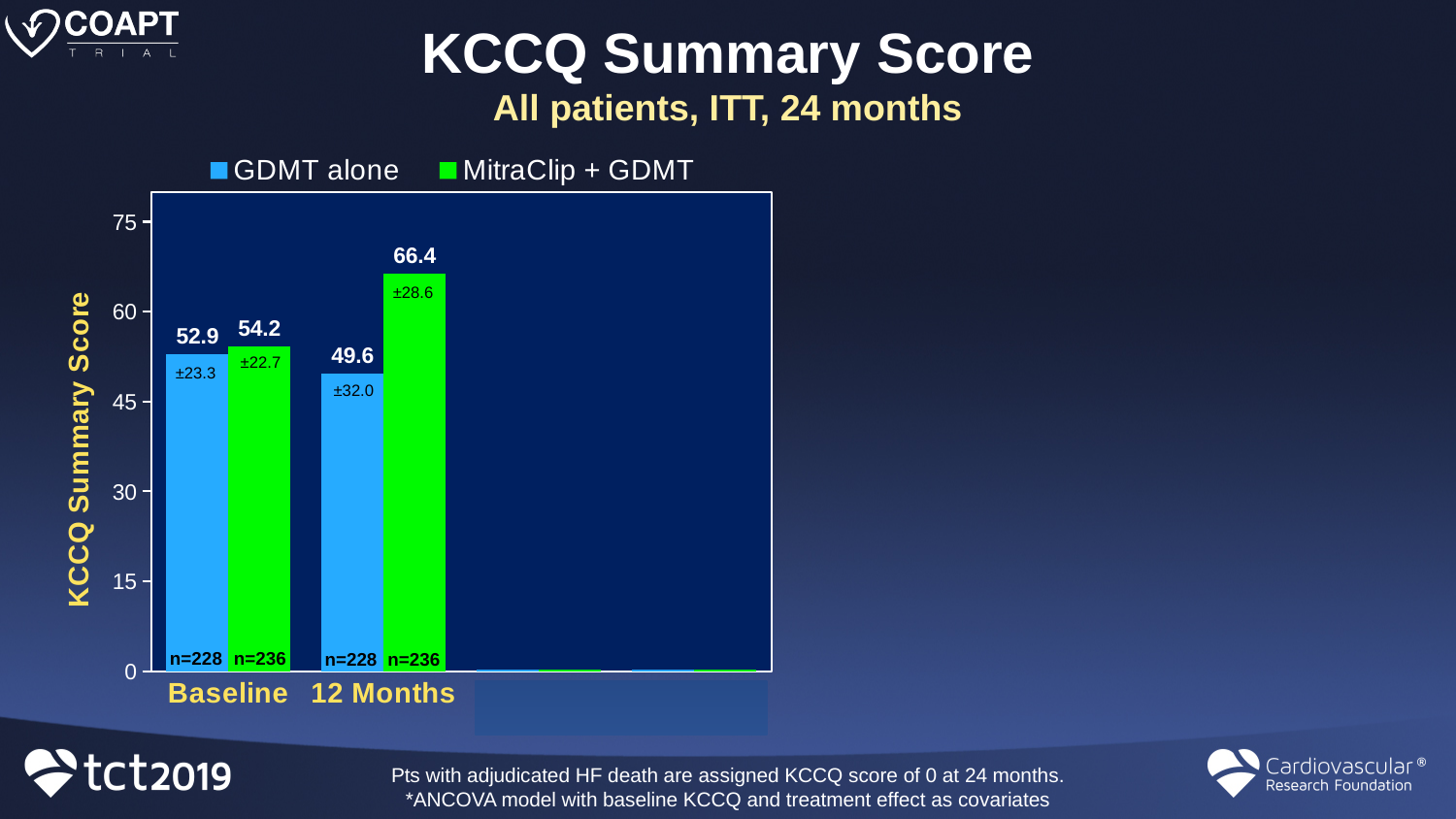
What is the KCCQ Summary Score for GDMT alone at Baseline? 52.9 What is the difference between the MitraClip + GDMT and GDMT alone scores at 12 Months? 16.8 Which bar shows the highest KCCQ Summary Score? MitraClip + GDMT at 12 Months What is the KCCQ Summary Score for MitraClip + GDMT at 12 Months? 66.4 What is the KCCQ Summary Score for MitraClip + GDMT at Baseline? 54.2 At 12 Months, which group has the higher KCCQ Summary Score, GDMT alone or MitraClip + GDMT? MitraClip + GDMT Does the GDMT alone score rise or fall from Baseline to 12 Months? Fall What kind of chart is shown on the slide? Bar chart How many series does the legend list? 2 What is the difference between the MitraClip + GDMT and GDMT alone scores at Baseline? 1.3 What is the KCCQ Summary Score for GDMT alone at 12 Months? 49.6 Which bar shows the lowest KCCQ Summary Score? GDMT alone at 12 Months